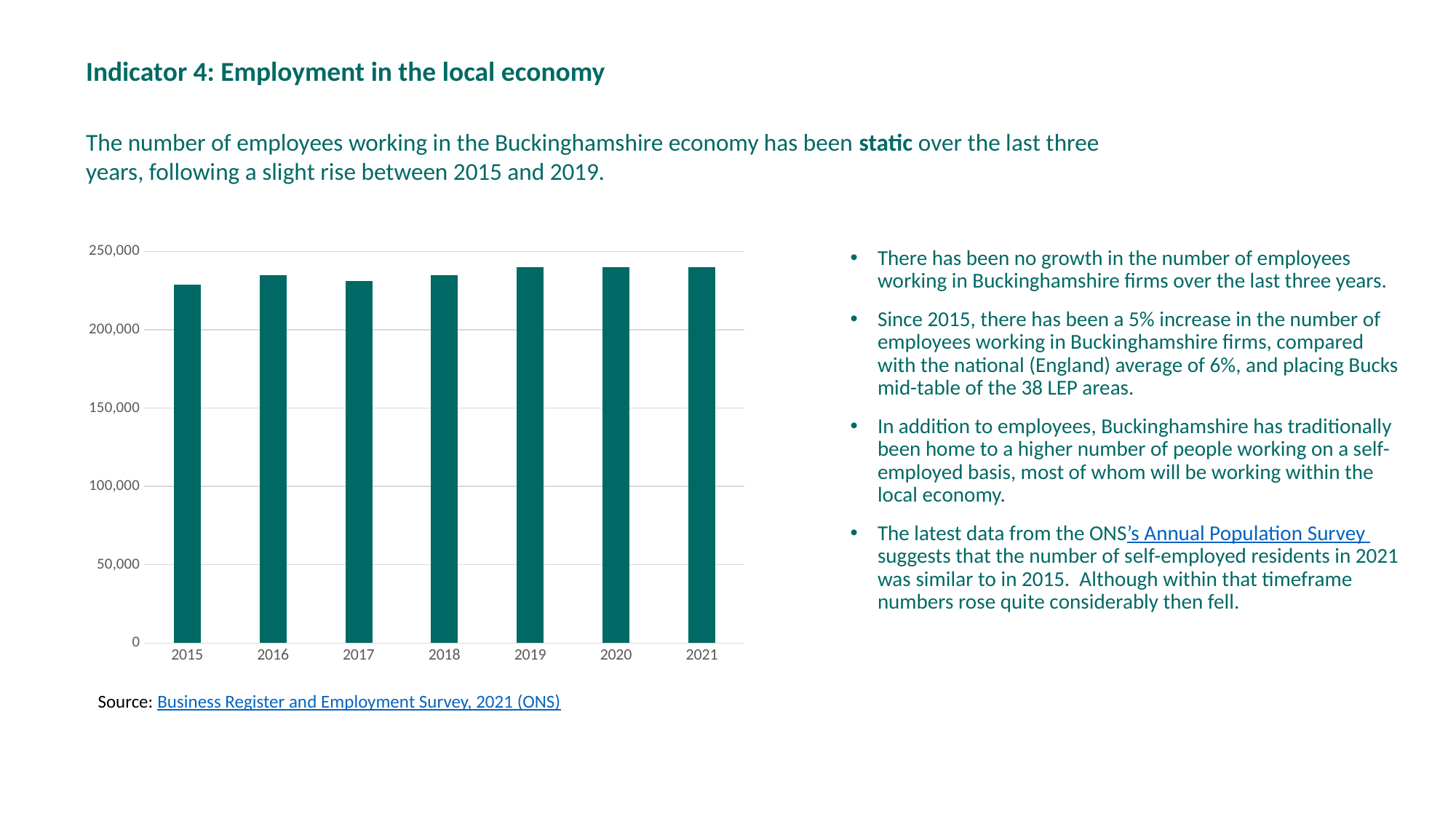
Which year has the lowest bar in the chart? 2015 Which is larger, the value for 2015 or the value for 2016? 2016 Is the value for 2019 greater or less than 250,000? less How many years are shown on the x axis of the chart? 7 Which is larger, the value for 2015 or the value for 2019? 2019 Is the value for 2017 greater or less than 250,000? less What kind of chart is shown on the slide? bar chart Do the values generally rise or fall from 2015 to 2019? rise What is the highest value labelled on the y axis of the chart? 250,000 What is the first year shown on the x axis of the chart? 2015 Is the value for 2015 greater or less than 200,000? greater